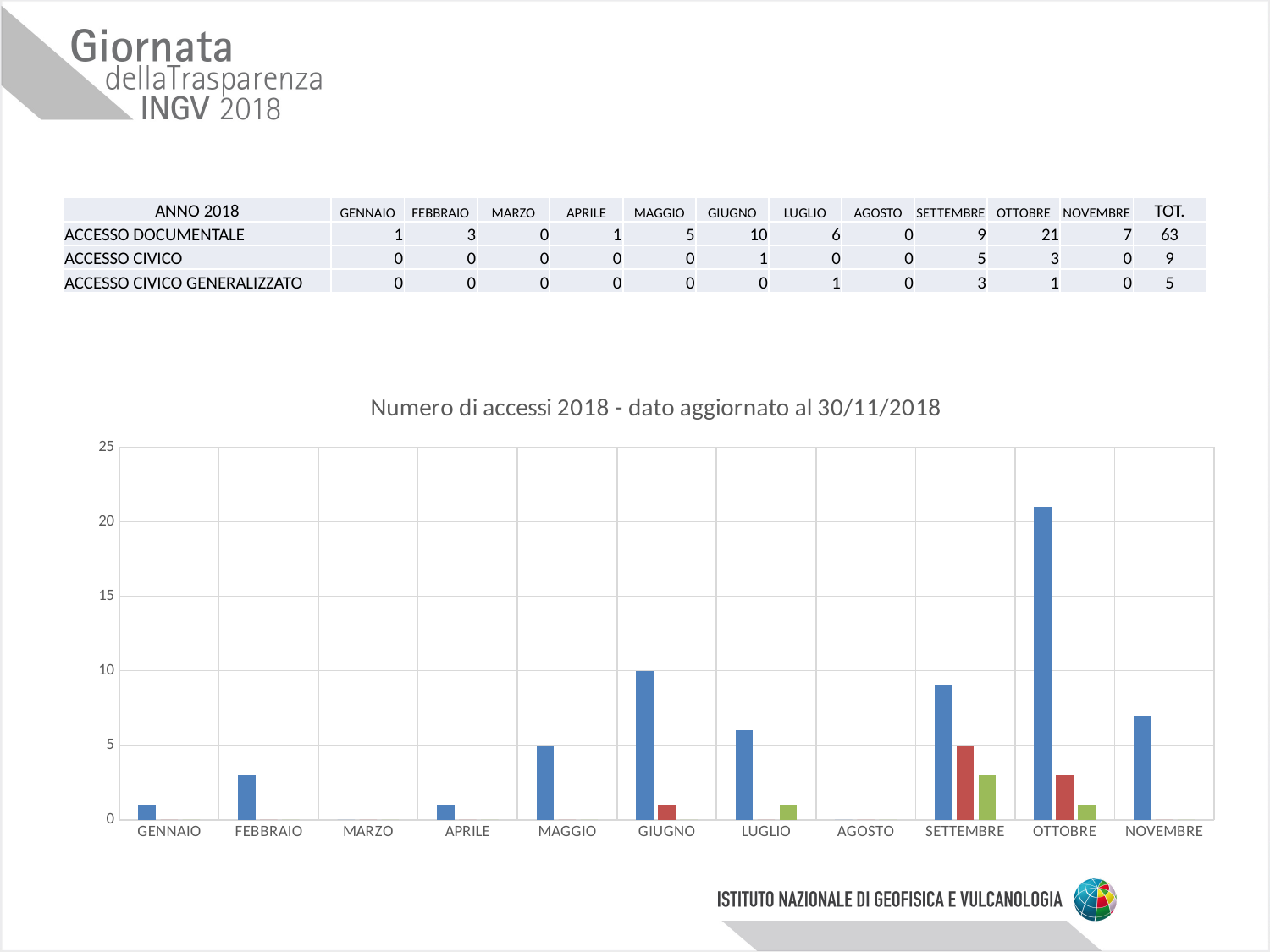
What is the total (TOT.) of ACCESSO DOCUMENTALE for 2018 shown in the table? 63 What is the value of ACCESSO CIVICO GENERALIZZATO in SETTEMBRE? 3 In which month does ACCESSO DOCUMENTALE reach its highest value? OTTOBRE Which month has the larger ACCESSO DOCUMENTALE value, GIUGNO or LUGLIO? GIUGNO Is the ACCESSO DOCUMENTALE value for OTTOBRE greater or less than 20? greater What is the value of ACCESSO DOCUMENTALE in GIUGNO? 10 What is the value of ACCESSO DOCUMENTALE in NOVEMBRE? 7 What is the value of ACCESSO CIVICO in SETTEMBRE? 5 What is the difference between the ACCESSO DOCUMENTALE values for OTTOBRE and SETTEMBRE? 12 What is the title of the chart? Numero di accessi 2018 - dato aggiornato al 30/11/2018 What kind of chart is shown under the title 'Numero di accessi 2018 - dato aggiornato al 30/11/2018'? bar chart How many months are shown on the x axis of the chart? 11